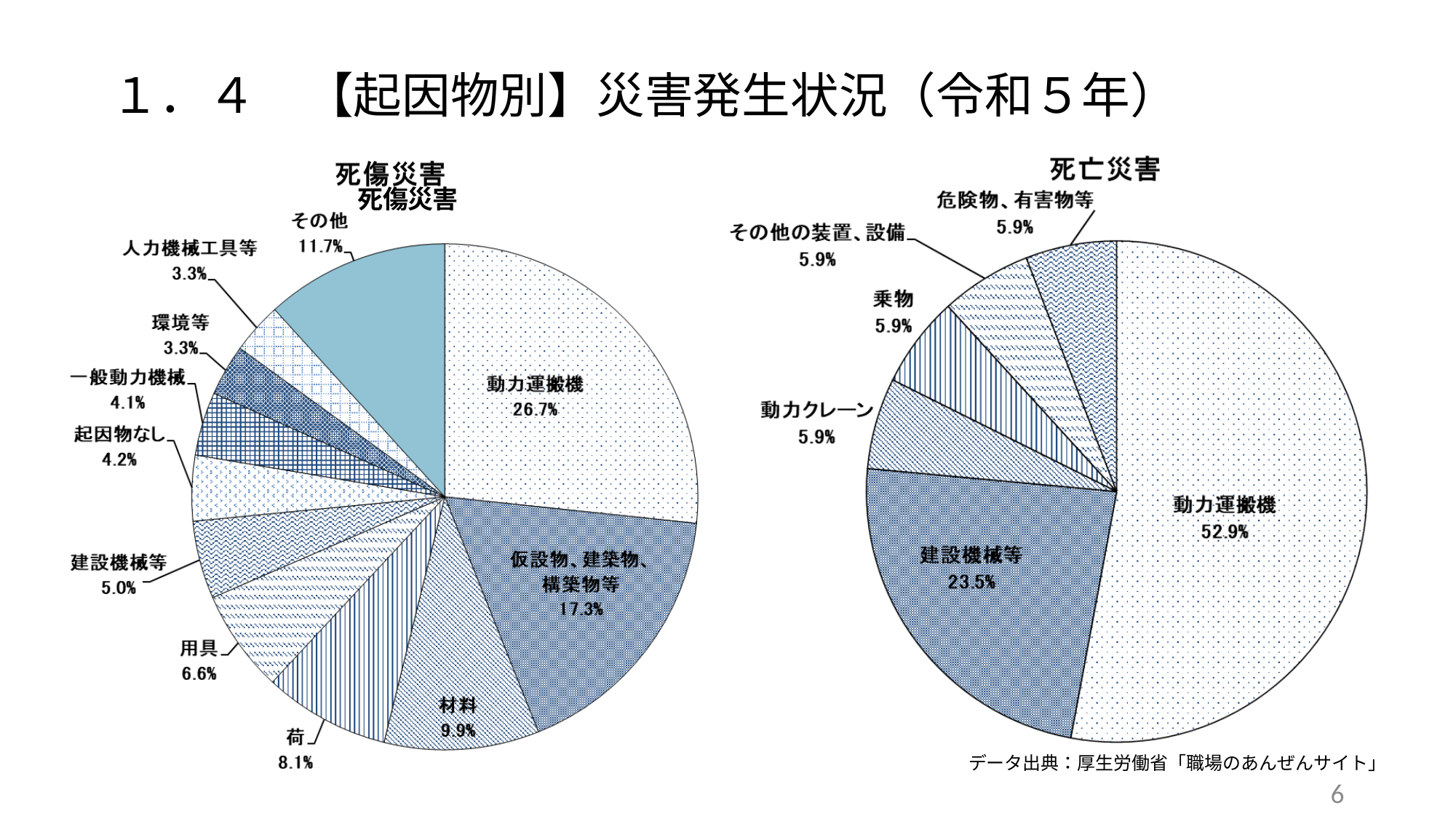
In the 死傷災害 pie chart, how many categories are shown? 11 In the 死傷災害 pie chart, which is larger, 建設機械等 or 起因物なし? 建設機械等 In the 死傷災害 pie chart, what is the share for 仮設物、建築物、構築物等? 17.3% In the 死亡災害 pie chart, what is the share for 動力運搬機? 52.9% In the 死亡災害 pie chart, how many categories are shown? 6 In the 死亡災害 pie chart, what is the difference between the shares of 動力運搬機 and 建設機械等? 29.4% In the 死亡災害 pie chart, what is the share for 建設機械等? 23.5% In the 死傷災害 pie chart, what is the difference between the shares of 材料 and 用具? 3.3% In the 死傷災害 pie chart, which category has the largest share? 動力運搬機 In the 死傷災害 pie chart, what is the share for 動力運搬機? 26.7% In the 死傷災害 pie chart, what is the share for 荷? 8.1% What type of chart is used on this slide? Pie chart